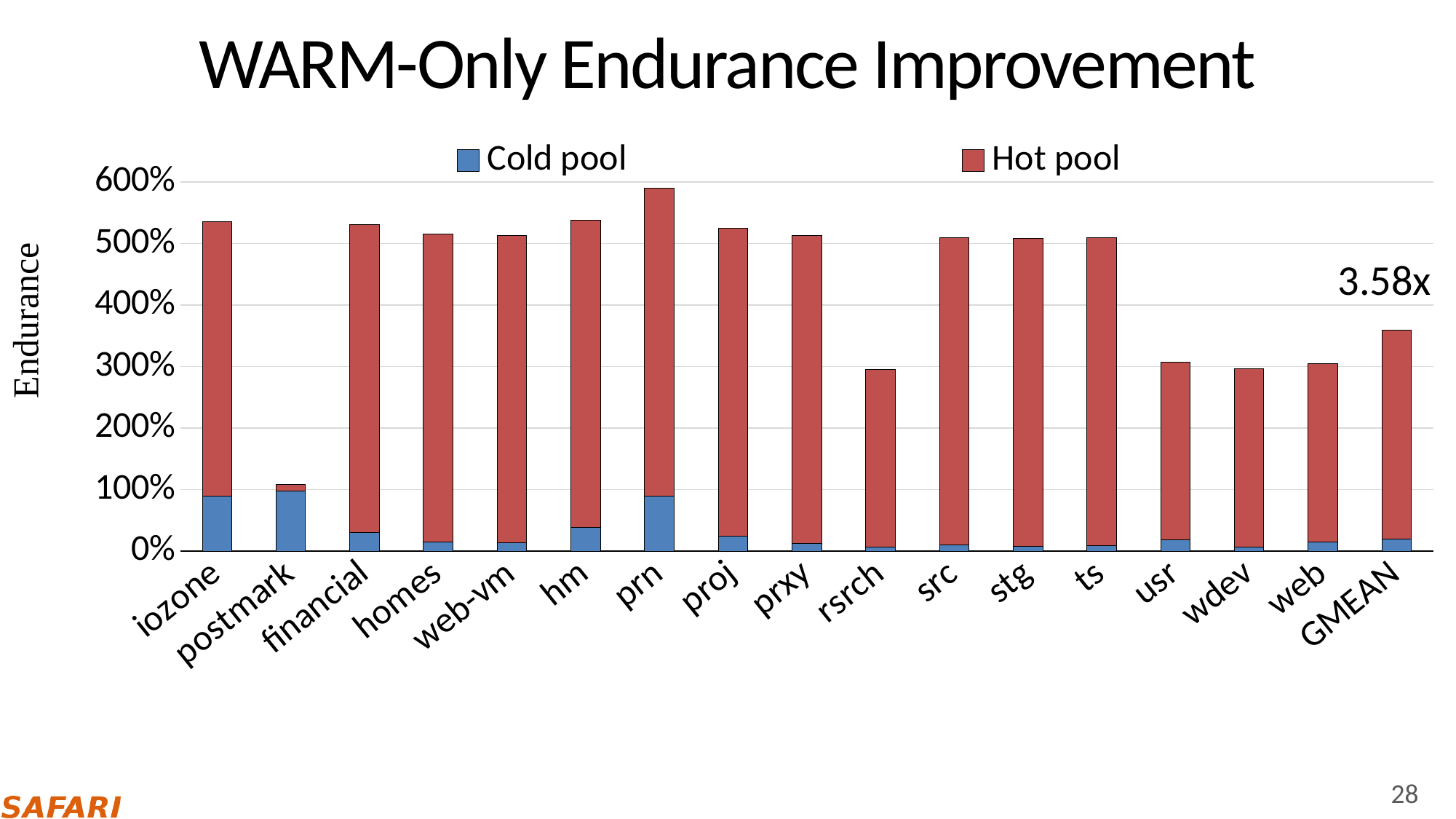
What kind of chart is shown on the slide? bar chart Is the total value for prn greater or less than 500%? greater Is the total value for rsrch greater or less than 400%? less How many categories are shown along the x axis? 17 Is the total value for postmark greater or less than 200%? less What are the two legend entries of the chart? Cold pool, Hot pool What value is labelled above the GMEAN bar? 3.58x Which category has the highest total endurance improvement? prn Which has a larger total endurance improvement, iozone or usr? iozone Which has a larger Cold pool value, postmark or wdev? postmark Which category has the lowest total endurance improvement? postmark How many series does the legend list? 2